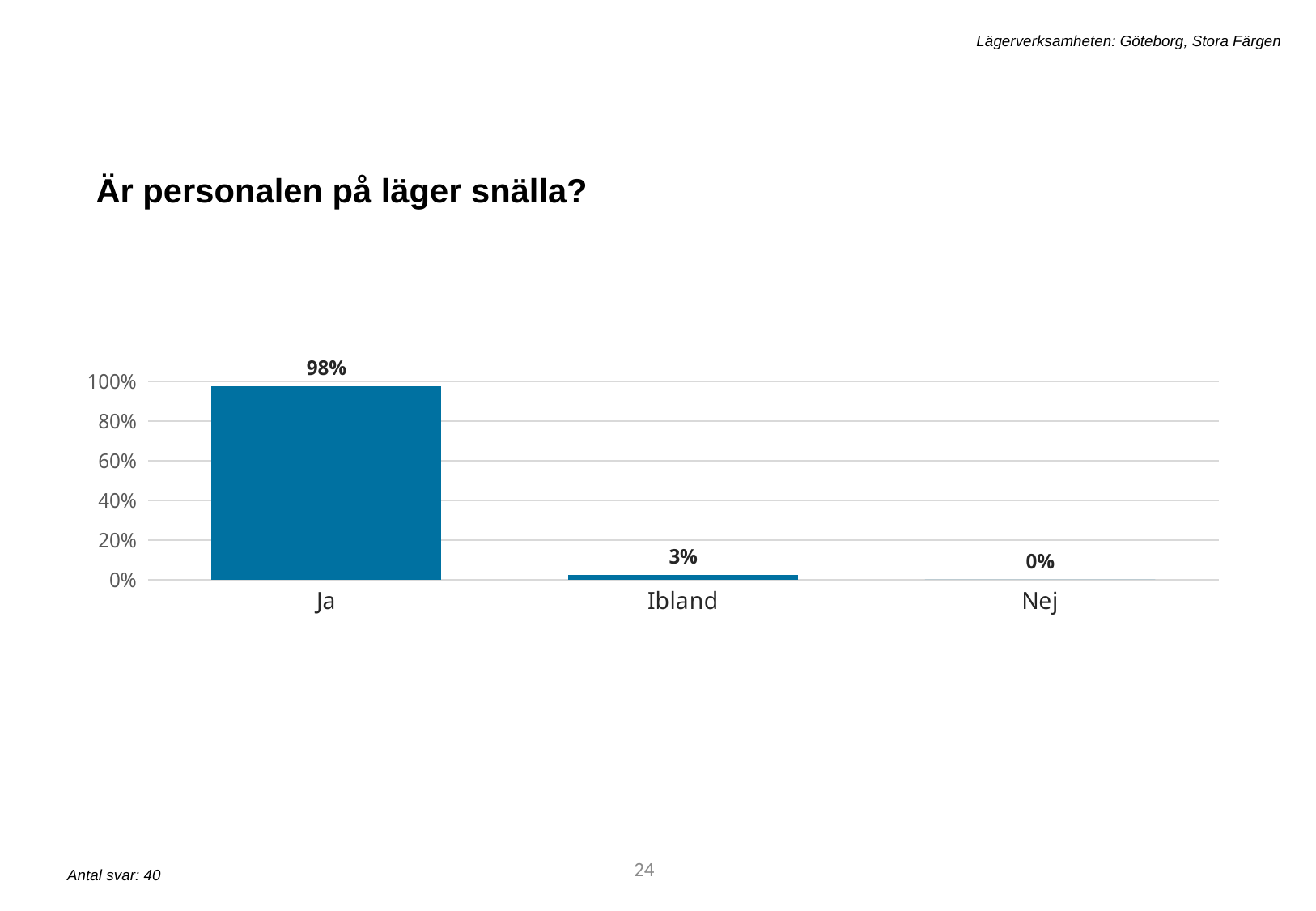
Which category has the highest value? Ja What is the difference between the values for Ja and Ibland? 95% What is the value for Ja? 98% Which is larger, the value for Ibland or the value for Nej? Ibland What is the title of the chart? Är personalen på läger snälla? What is the value for Ibland? 3% How many categories are shown on the x axis? 3 Which category has the lowest value? Nej Is the value for Ja greater or less than 80%? greater Do the values rise or fall from left to right along the x axis? fall What is the value for Nej? 0% What kind of chart is shown on the slide? bar chart